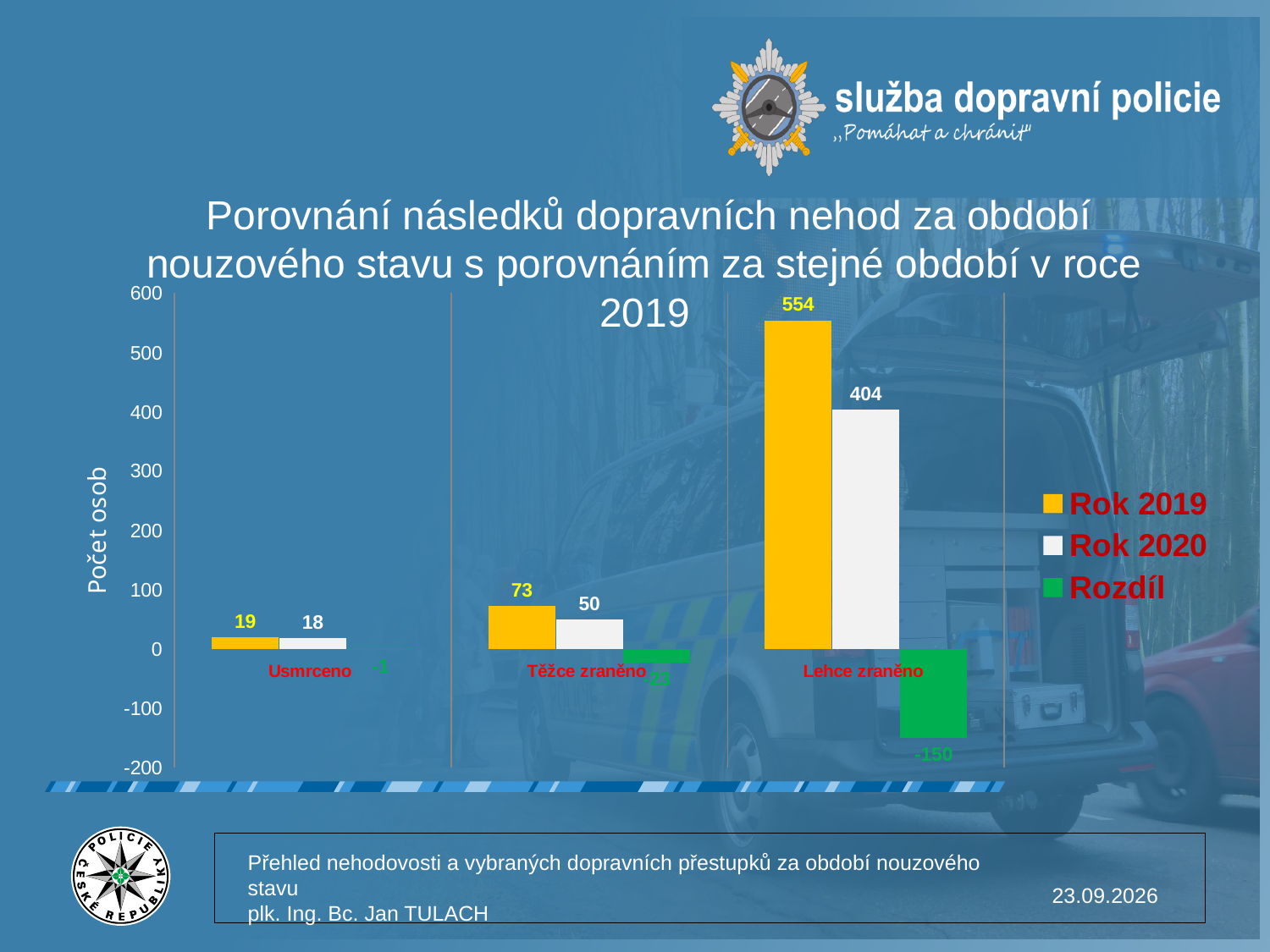
What is the Rok 2019 value for Těžce zraněno? 73 What is the Rok 2020 value for Lehce zraněno? 404 What is the difference between the Rok 2019 and Rok 2020 values for Těžce zraněno? 23 What is the Rozdíl value for Usmrceno? -1 What is the Rok 2020 value for Usmrceno? 18 What kind of chart is shown on the slide? bar chart What is the Rok 2019 value for Lehce zraněno? 554 Which is larger for Lehce zraněno: the Rok 2019 value or the Rok 2020 value? Rok 2019 Which category has the lowest Rok 2020 value? Usmrceno Which category has the highest Rok 2019 value? Lehce zraněno How many series does the legend list? 3 How many categories are shown on the x axis? 3